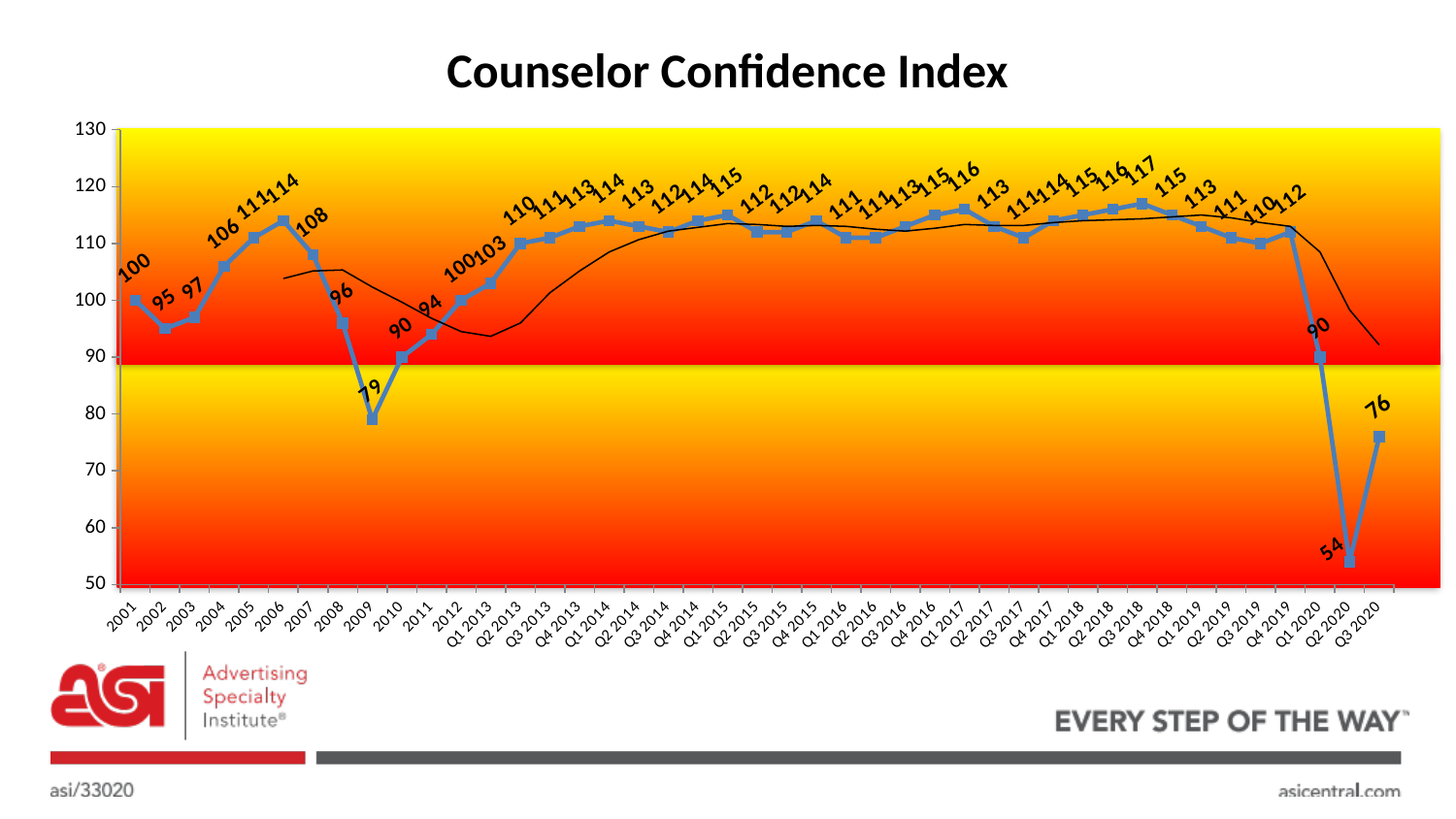
What kind of chart is used to show the Counselor Confidence Index? Line chart What is the Counselor Confidence Index value for Q3 2020? 76 Which period has the lowest Counselor Confidence Index value? Q2 2020 Which period has the highest Counselor Confidence Index value? Q3 2018 What is the Counselor Confidence Index value for Q2 2020? 54 Does the Counselor Confidence Index rise or fall from Q4 2019 to Q2 2020? Fall What is the Counselor Confidence Index value for 2006? 114 Which is larger, the Counselor Confidence Index value for 2009 or for Q3 2020? 2009 Which is larger, the Counselor Confidence Index value for 2001 or for 2012? They are equal (100) What is the Counselor Confidence Index value for 2009? 79 What is the difference between the Counselor Confidence Index values for Q1 2020 and Q2 2020? 36 What is the title of the chart? Counselor Confidence Index